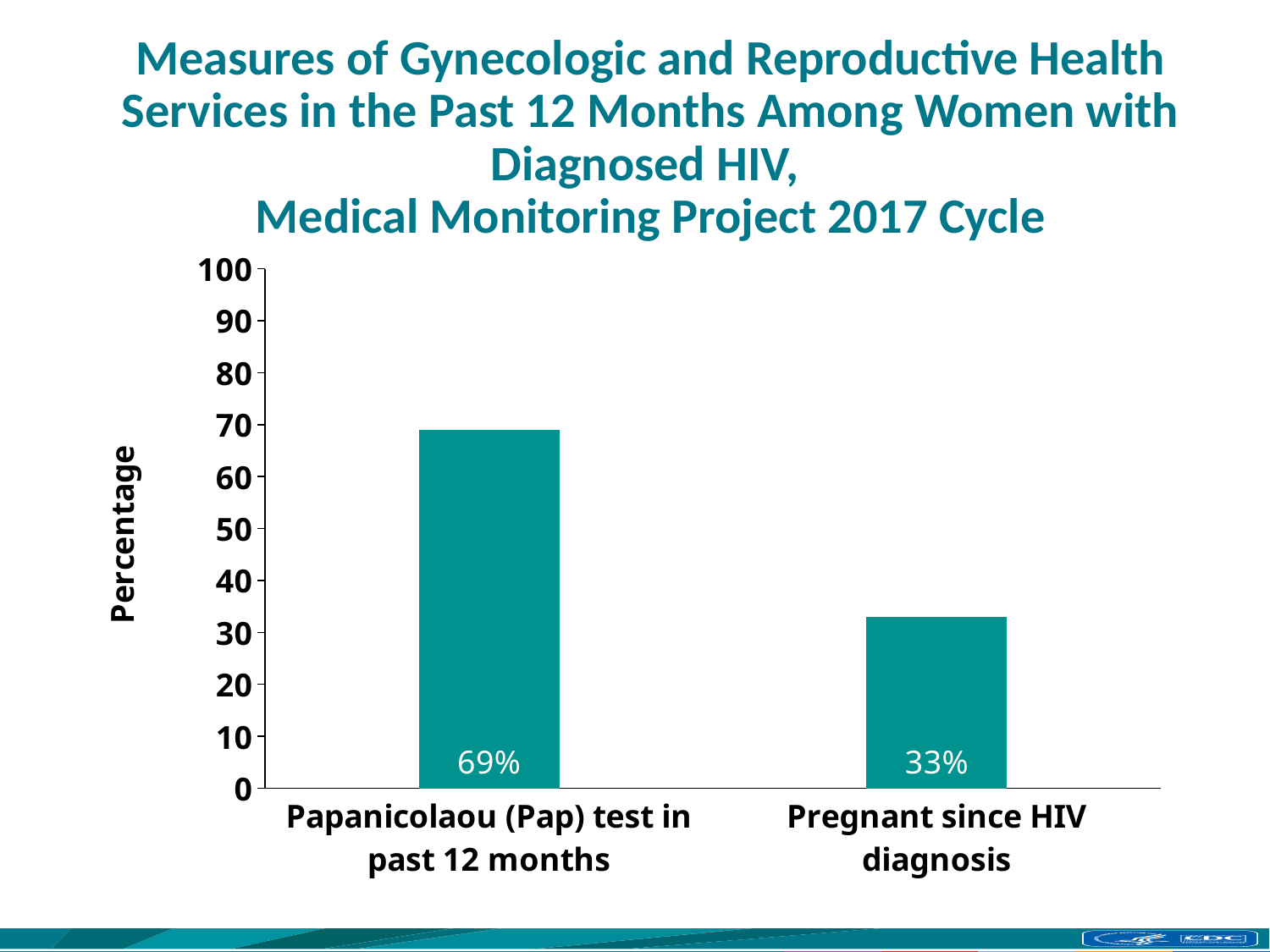
What is the difference between the value for Papanicolaou (Pap) test in past 12 months and the value for Pregnant since HIV diagnosis? 36% Is the value for Pregnant since HIV diagnosis greater or less than 50? less Which category has the highest value? Papanicolaou (Pap) test in past 12 months Which category has the lowest value? Pregnant since HIV diagnosis What kind of chart is shown on the slide? bar chart Which is larger: the value for Papanicolaou (Pap) test in past 12 months or the value for Pregnant since HIV diagnosis? Papanicolaou (Pap) test in past 12 months Is the value for Papanicolaou (Pap) test in past 12 months greater or less than 60? greater What is the label of the vertical axis? Percentage What is the value for Pregnant since HIV diagnosis? 33% What is the maximum value shown on the vertical axis? 100 How many categories are shown in the chart? 2 What is the value for Papanicolaou (Pap) test in past 12 months? 69%